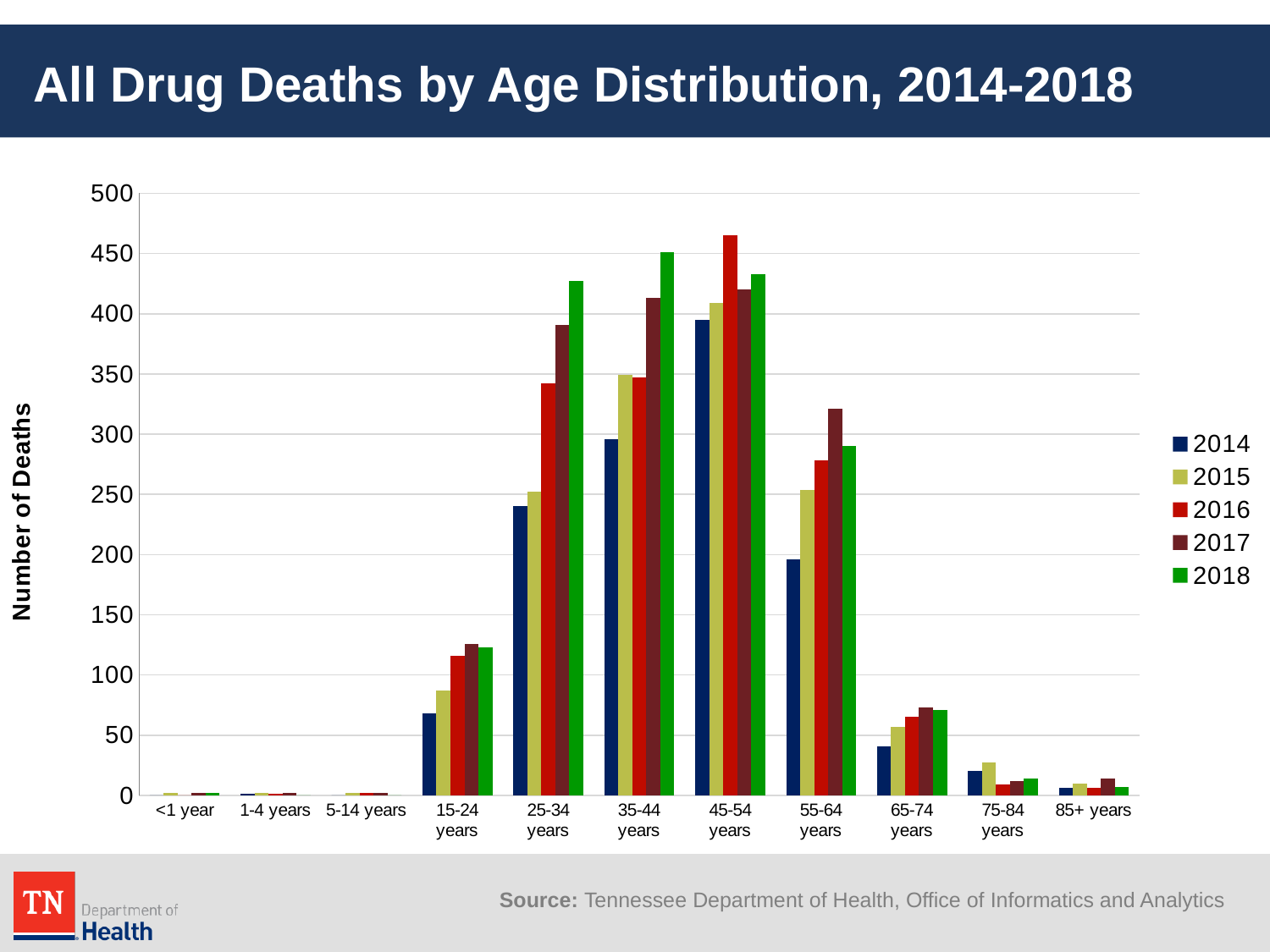
What is the title of the y axis? Number of Deaths Which age group has the tallest bar in the chart? 45-54 years Is the 2017 value for 55-64 years greater or less than 300? greater What kind of chart is shown on the slide? bar chart How many age groups are shown on the x axis? 11 For the 35-44 years age group, which is larger: the 2014 value or the 2018 value? 2018 For the 25-34 years age group, do the values rise or fall from 2014 to 2018? rise For the 45-54 years age group, which is larger: the 2016 value or the 2017 value? 2016 How many series does the legend list? 5 Which year has the lowest bar for the 15-24 years age group? 2014 Is the 2018 value for 25-34 years greater or less than 400? greater Is the 2014 value for 65-74 years greater or less than 50? less